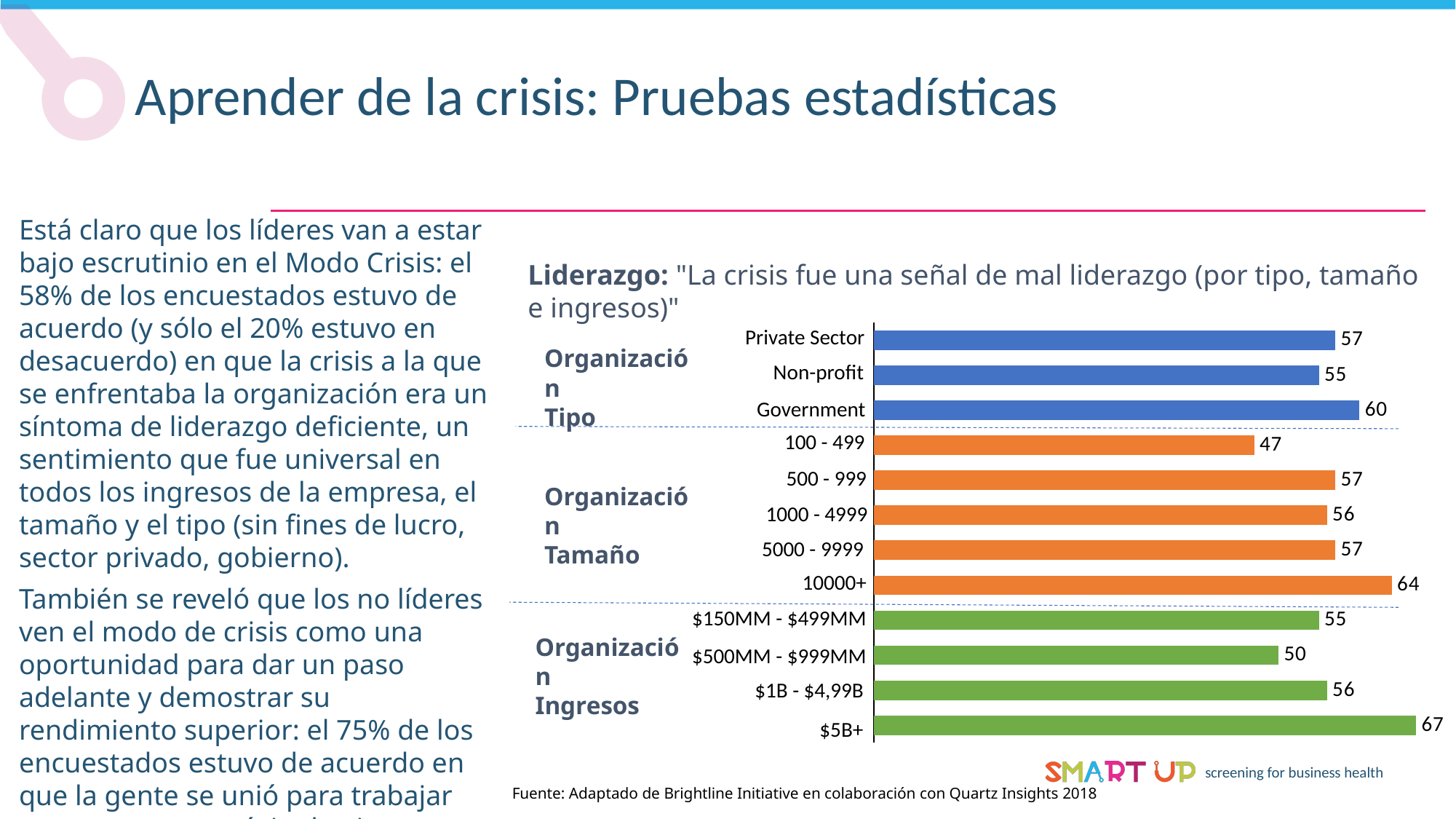
Which category has the lowest value in the chart? 100 - 499 What is the value for the 100 - 499 size category? 47 What is the value for Government? 60 Which category has the highest value in the chart? $5B+ What kind of chart is shown on the slide? Bar chart What is the difference between the values for 10000+ and 100 - 499? 17 What is the value for $5B+? 67 What is the value for $500MM - $999MM? 50 How many categories are plotted in the chart? 12 What colour are the bars for the Organización Tamaño group? Orange What is the difference between the values for Government and Non-profit? 5 Which is larger, the value for Private Sector or the value for Non-profit? Private Sector